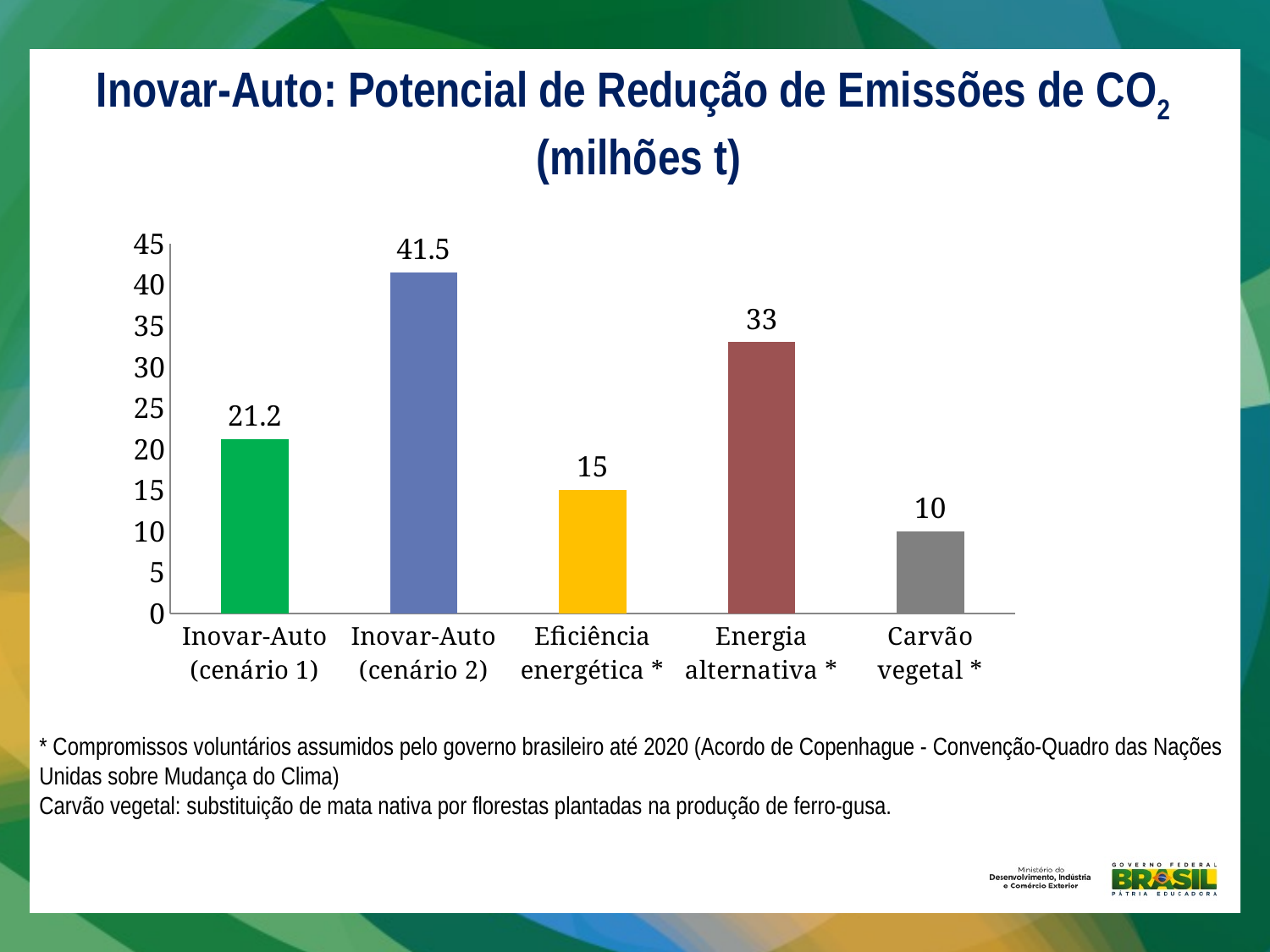
Which category has the highest value? Inovar-Auto (cenário 2) What kind of chart is shown on the slide? Bar chart Which is larger, Energia alternativa * or Inovar-Auto (cenário 1)? Energia alternativa * What is the difference between Inovar-Auto (cenário 2) and Inovar-Auto (cenário 1)? 20.3 Which category has the lowest value? Carvão vegetal * What is the value for Inovar-Auto (cenário 2)? 41.5 What is the value for Energia alternativa *? 33 What is the value for Inovar-Auto (cenário 1)? 21.2 How many categories are shown in the chart? 5 What is the value for Carvão vegetal *? 10 What is the difference between Energia alternativa * and Eficiência energética *? 18 What is the title of the chart? Inovar-Auto: Potencial de Redução de Emissões de CO2 (milhões t)